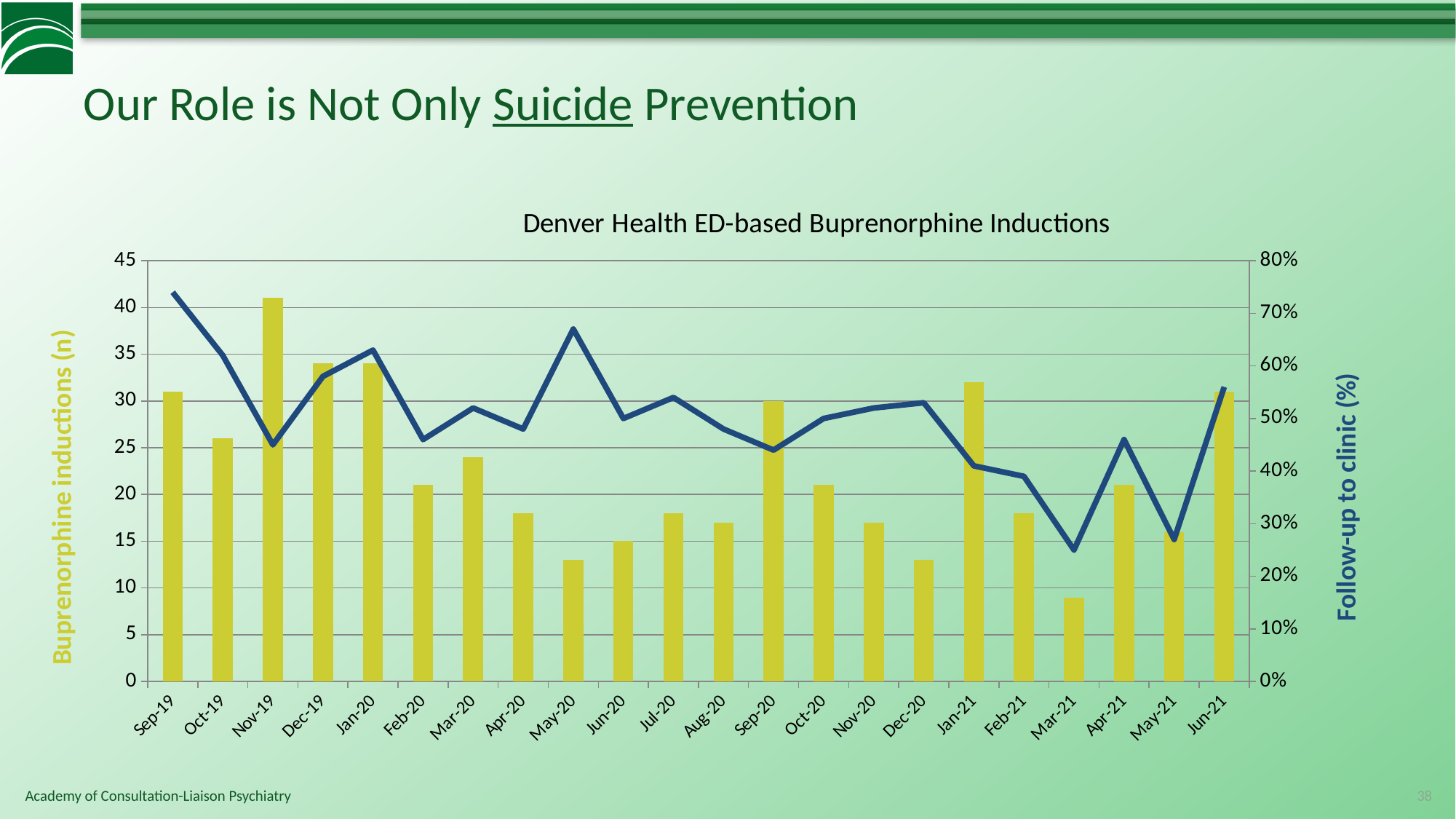
Is the number of buprenorphine inductions for Nov-19 greater or less than 35? greater What kind of chart is shown on the slide? Combined bar and line chart Which month has the lowest number of buprenorphine inductions? Mar-21 Is the follow-up to clinic percentage for Mar-21 greater or less than 30%? less Is the follow-up to clinic percentage for Sep-19 greater or less than 70%? greater Which month has more buprenorphine inductions, Sep-20 or Dec-20? Sep-20 Which month has the highest follow-up to clinic percentage? Sep-19 How many months are plotted along the x axis of the chart? 22 Does the follow-up to clinic percentage rise or fall from Sep-19 to Nov-19? fall Which month has the highest number of buprenorphine inductions? Nov-19 What is the title of the chart? Denver Health ED-based Buprenorphine Inductions